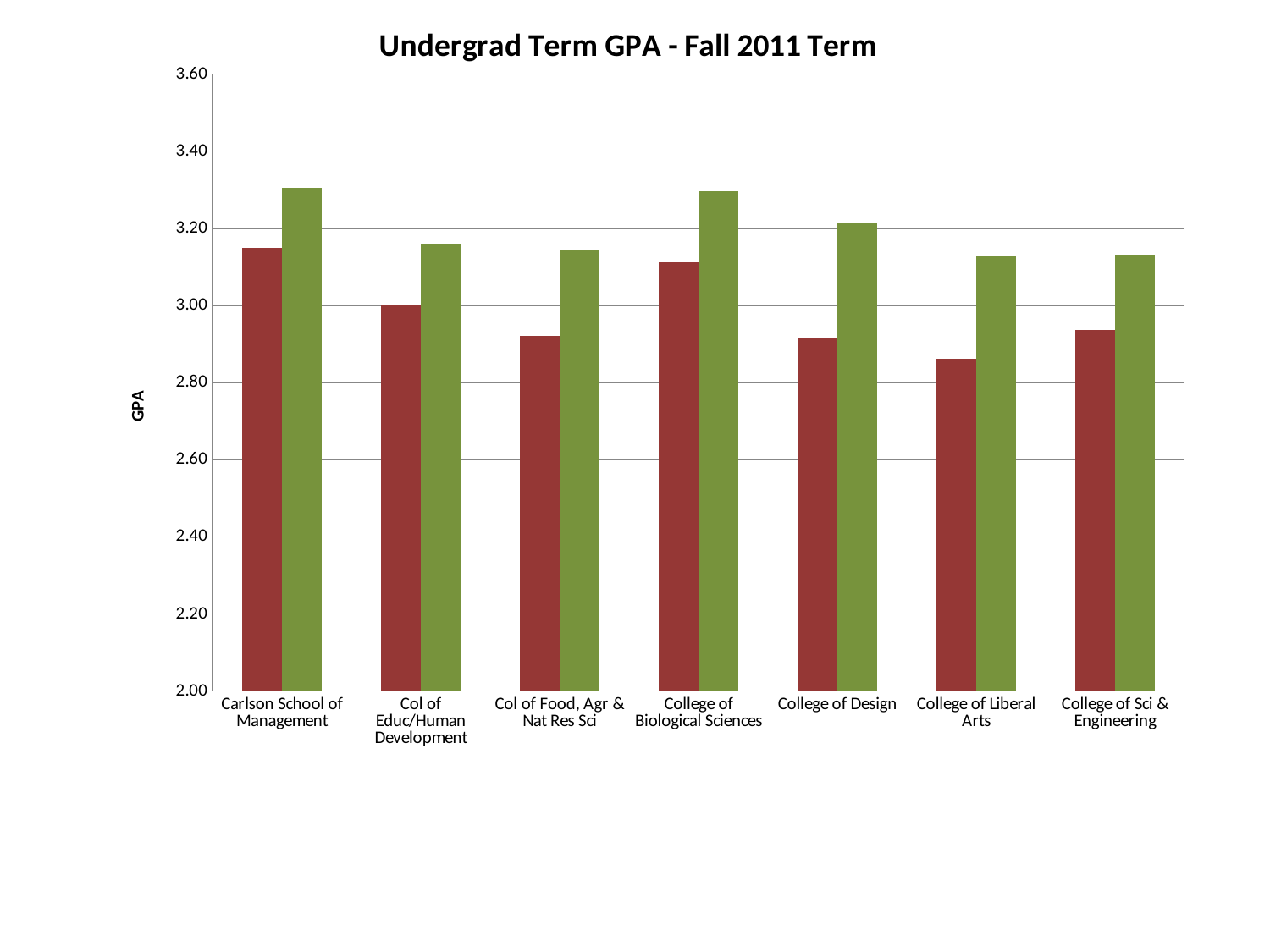
Is the red bar for Col of Food, Agr & Nat Res Sci greater or less than 3.00? less Is the red bar for College of Liberal Arts greater or less than 3.00? less Which is larger, the red bar for College of Biological Sciences or the red bar for College of Design? College of Biological Sciences What is the title of the chart? Undergrad Term GPA - Fall 2011 Term Which is larger, the green bar for College of Design or the green bar for College of Liberal Arts? College of Design Is the green bar for Carlson School of Management greater or less than 3.20? greater What is the label on the vertical axis of the chart? GPA How many colleges are shown along the x axis of the chart? 7 What kind of chart is shown on the slide? bar chart Which college has the highest red bar? Carlson School of Management Which college has the lowest red bar? College of Liberal Arts